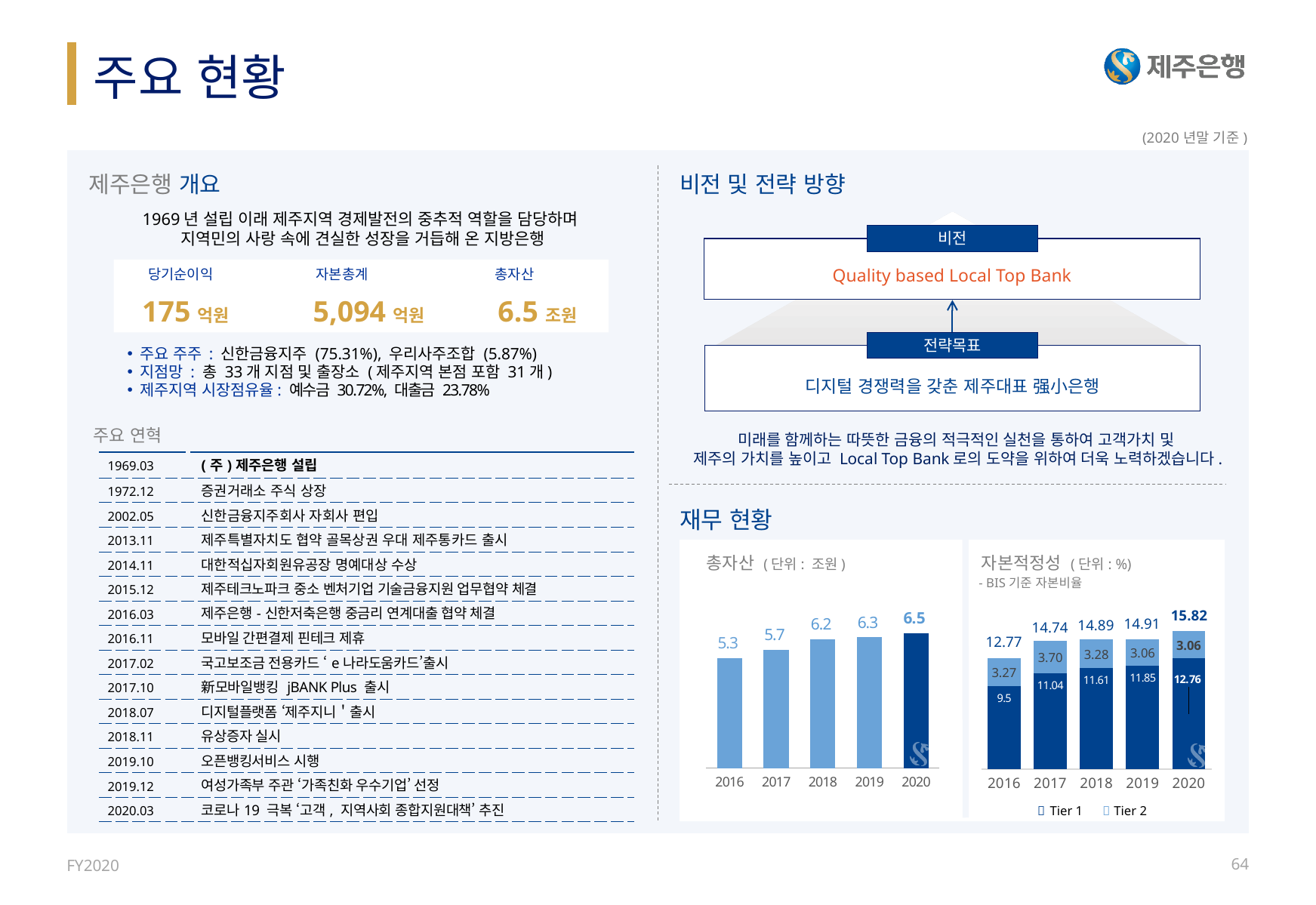
In the 총자산 chart, what is the value for 2016? 5.3 In the 자본적정성 chart, what is the total for 2018? 14.89 What kind of chart is the 자본적정성 chart? stacked bar chart In the 총자산 chart, which year has the lowest value? 2016 In the 자본적정성 chart, which year has the highest total? 2020 How many series does the legend of the 자본적정성 chart list? 2 In the 총자산 chart, what is the difference between the 2020 and 2016 values? 1.2 In the 총자산 chart, do the values rise or fall from 2016 to 2020? rise In the 총자산 chart, how many years are plotted? 5 In the 자본적정성 chart, what is the Tier 2 value for 2017? 3.70 In the 총자산 chart, what is the value for 2020? 6.5 In the 자본적정성 chart, what is the Tier 1 value for 2020? 12.76